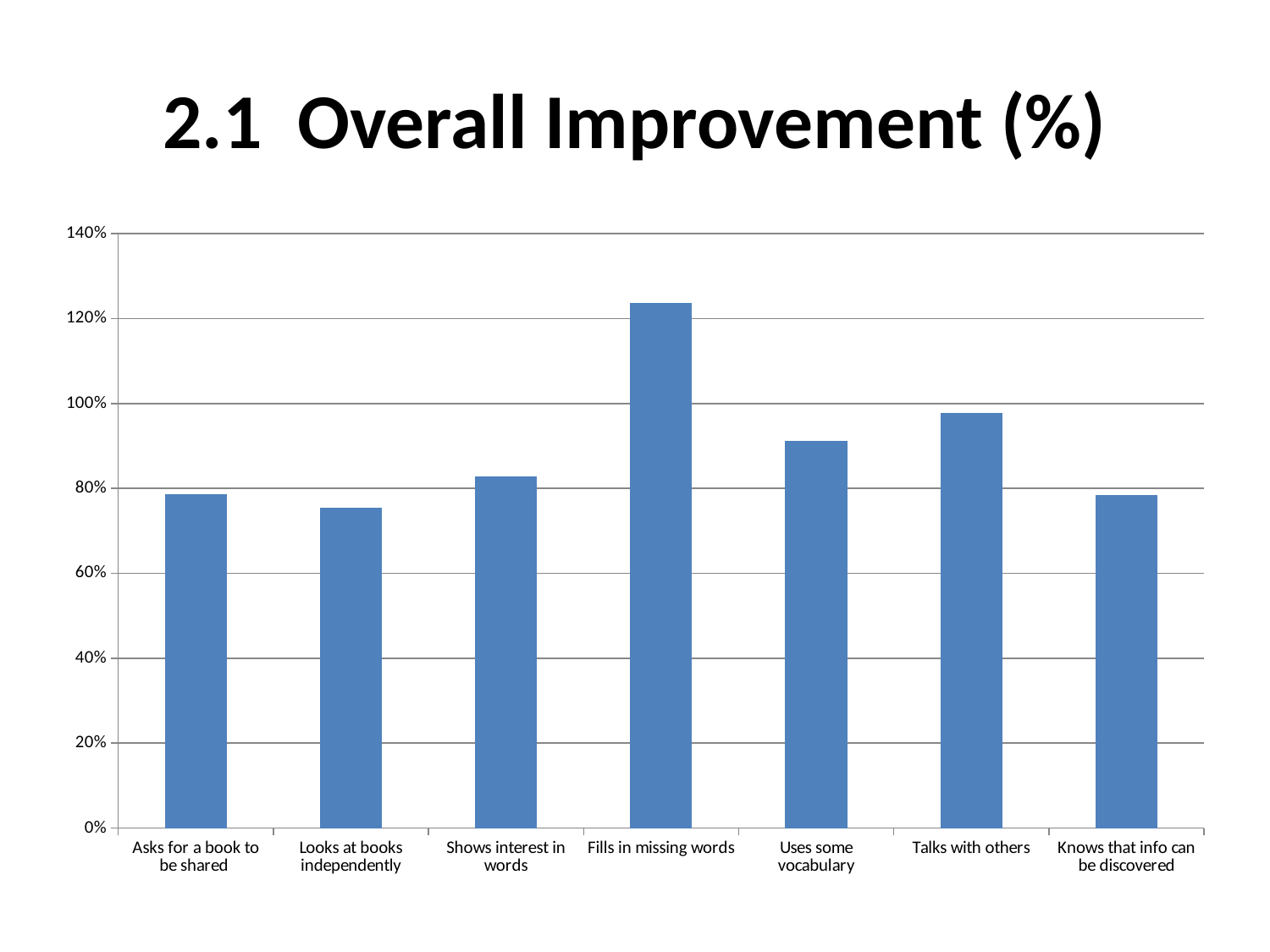
Is the value for Uses some vocabulary greater or less than 80%? greater What kind of chart is shown on the slide? Bar chart Is the value for Looks at books independently greater or less than 80%? less Which category has the lowest value? Looks at books independently Is the value for Fills in missing words greater or less than 100%? greater What is the title of the chart? 2.1 Overall Improvement (%) How many categories are shown on the x axis of the chart? 7 Which is larger, the value for Fills in missing words or the value for Talks with others? Fills in missing words Which is larger, the value for Uses some vocabulary or the value for Shows interest in words? Uses some vocabulary Which is larger, the value for Talks with others or the value for Uses some vocabulary? Talks with others Which category has the highest value? Fills in missing words